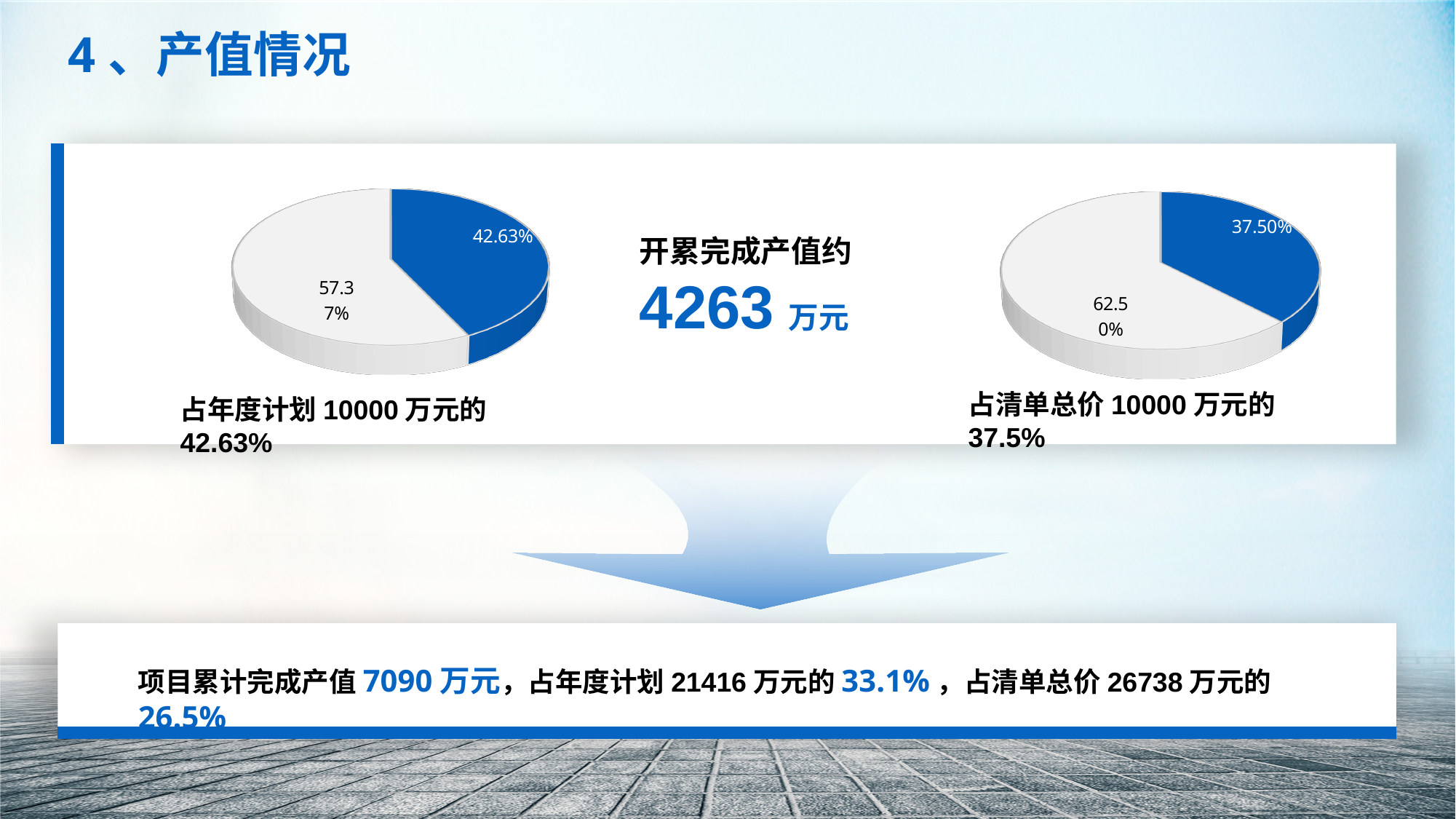
In the right pie chart, what value is shown on the grey slice? 62.50% In the right pie chart, what is the difference between the grey slice and the blue slice? 25 percentage points In the right pie chart, what value is shown on the blue slice? 37.50% How many slices does the right pie chart have? 2 In the left pie chart, which slice is larger, the blue one or the grey one? the grey one In the left pie chart, what value is shown on the blue slice? 42.63% What kind of chart is the right chart on the slide? pie chart In the left pie chart, what value is shown on the grey slice? 57.37% In the right pie chart, which slice is the smallest? the blue slice (37.50%) Which chart has the larger blue slice, the left pie chart or the right pie chart? the left pie chart What kind of chart is the left chart on the slide? pie chart How many slices does the left pie chart have? 2